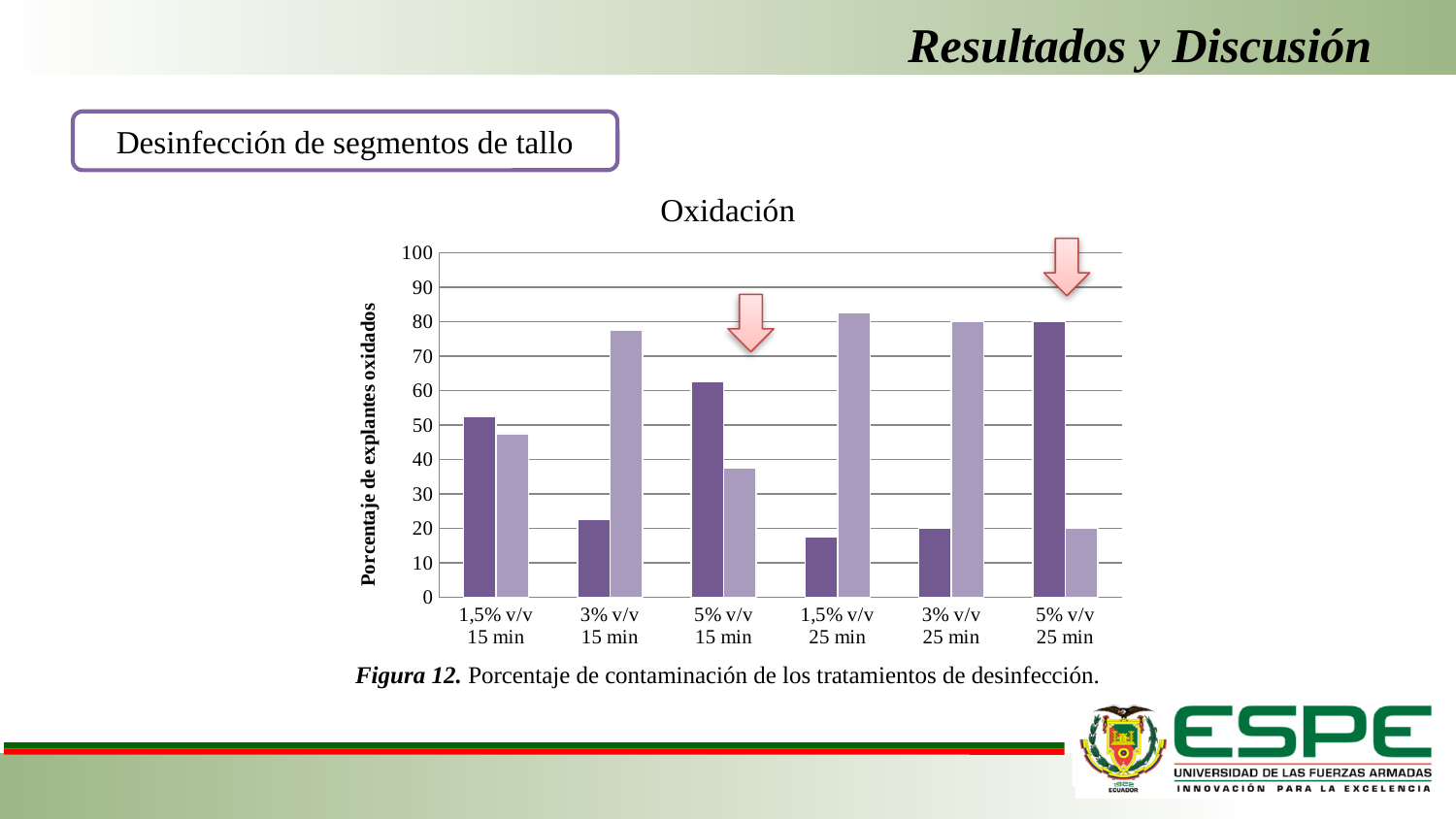
Is the light purple bar for 1,5% v/v 25 min greater or less than 70? greater What is the y-axis label of the "Oxidación" chart? Porcentaje de explantes oxidados Among the dark purple bars, which category has the highest value? 5% v/v 25 min Among the light purple bars, which category has the lowest value? 5% v/v 25 min How many treatment categories are shown on the x axis of the "Oxidación" chart? 6 For 3% v/v 15 min, which bar is larger, the dark purple or the light purple one? light purple Is the light purple bar for 3% v/v 15 min greater or less than 70? greater Is the dark purple bar for 5% v/v 25 min greater or less than 70? greater For 5% v/v 25 min, which bar is larger, the dark purple or the light purple one? dark purple What type of chart is shown under the title "Oxidación"? bar chart